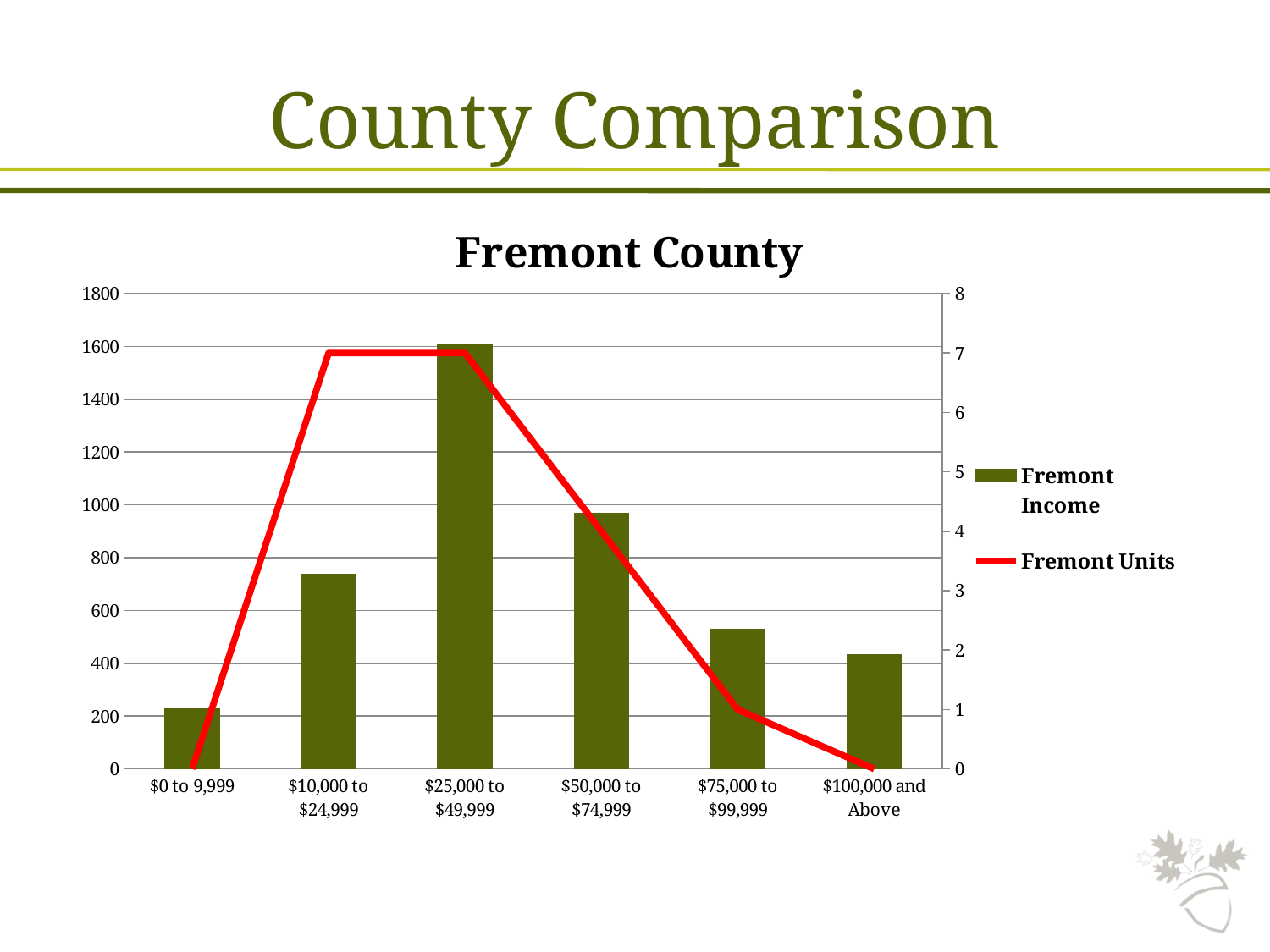
Which income category has the lowest Fremont Income bar? $0 to 9,999 What kind of chart is shown on the slide? A combination bar and line chart Which has the larger Fremont Income bar: $75,000 to $99,999 or $100,000 and Above? $75,000 to $99,999 What is the Fremont Units value for $10,000 to $24,999? 7 Is the Fremont Income value for $25,000 to $49,999 greater or less than 1400? greater Is the Fremont Income value for $10,000 to $24,999 greater or less than 800? less How many series does the legend list? 2 How many income categories are shown on the x axis? 6 What is the Fremont Units value for $100,000 and Above? 0 Which income category has the highest Fremont Income bar? $25,000 to $49,999 What is the Fremont Units value for $75,000 to $99,999? 1 Do the Fremont Income bars rise or fall from $25,000 to $49,999 through $100,000 and Above? fall